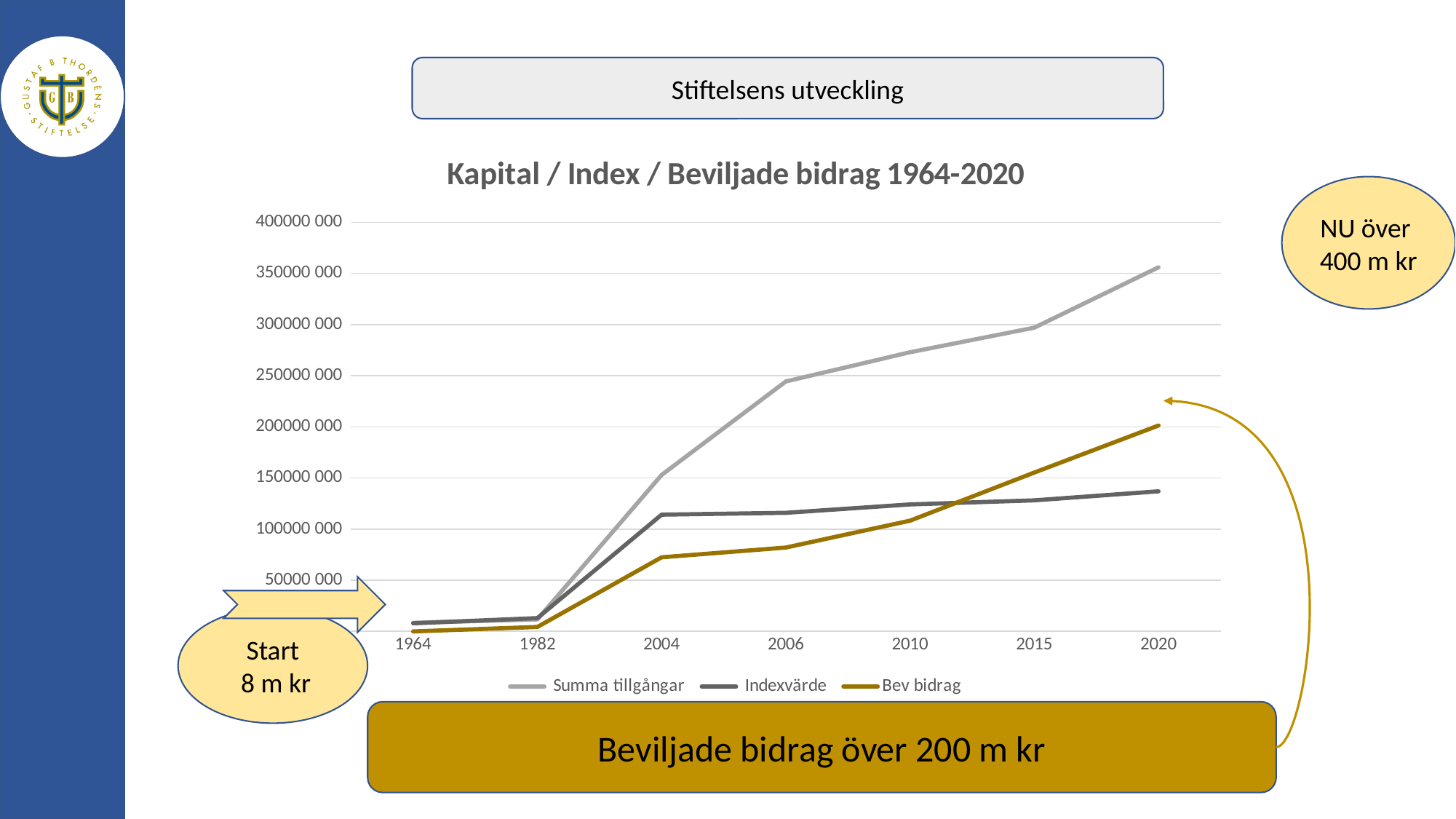
How many years are shown on the x axis of the chart? 7 In 2020, which is larger: Bev bidrag or Indexvärde? Bev bidrag Is the value for Bev bidrag in 2020 greater or less than 150000 000? greater How many series does the chart legend list? 3 What kind of chart is shown on the slide? line chart Does the Summa tillgångar line rise or fall from 1964 to 2020? rise What is the title of the chart? Kapital / Index / Beviljade bidrag 1964-2020 Is the value for Summa tillgångar in 2020 greater or less than 300000 000? greater In 2010, which is larger: Indexvärde or Bev bidrag? Indexvärde Is the value for Summa tillgångar in 2004 greater or less than 100000 000? greater Which series has the highest value in 2020? Summa tillgångar